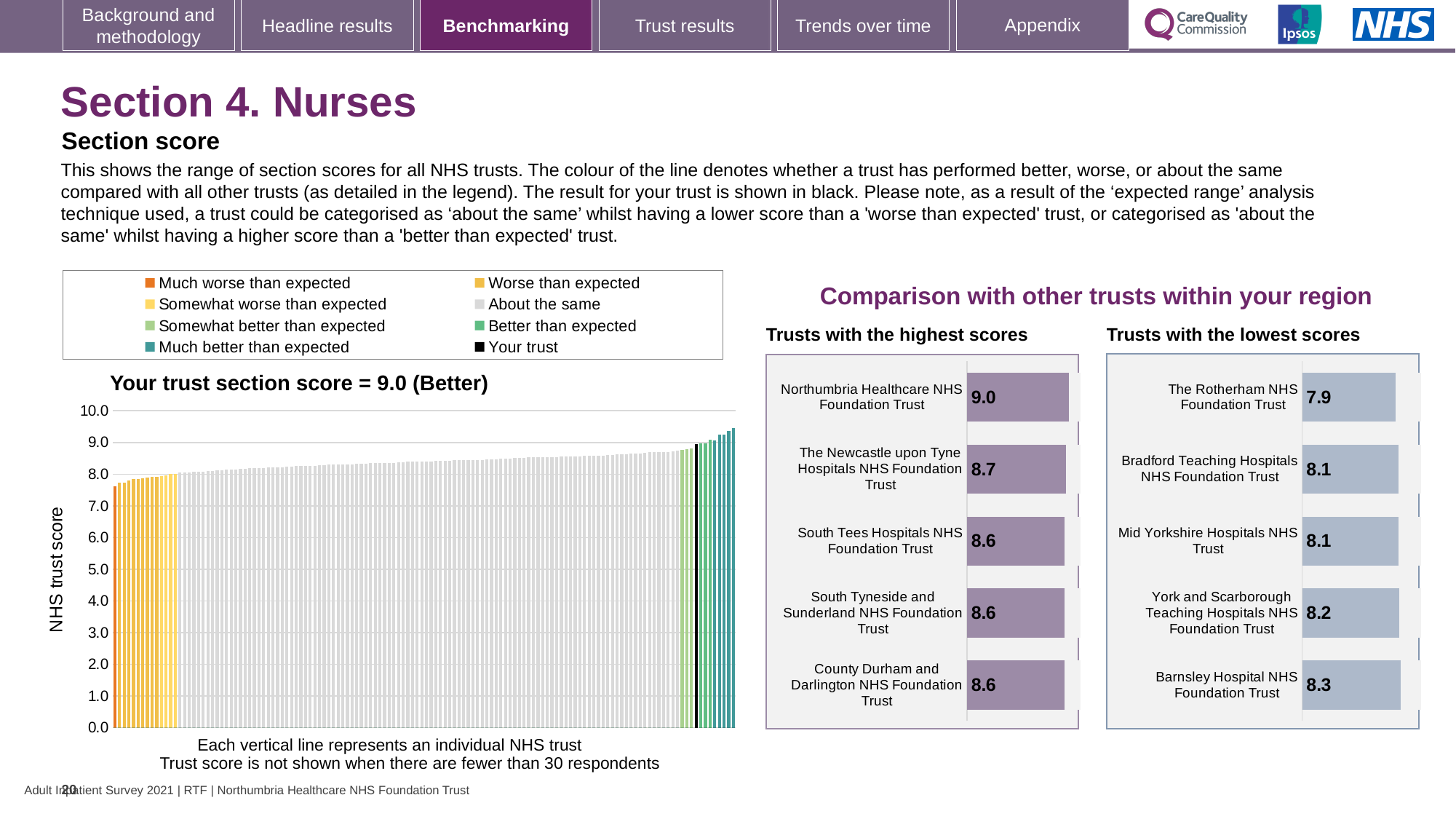
In the chart titled 'Trusts with the highest scores', which trust has the highest score? Northumbria Healthcare NHS Foundation Trust In the chart titled 'Trusts with the highest scores', what is the difference between the scores of Northumbria Healthcare NHS Foundation Trust and The Newcastle upon Tyne Hospitals NHS Foundation Trust? 0.3 In the chart titled 'Trusts with the lowest scores', which trust has the lowest score? The Rotherham NHS Foundation Trust In the chart titled 'Trusts with the highest scores', what is the score for The Newcastle upon Tyne Hospitals NHS Foundation Trust? 8.7 In the chart titled 'Your trust section score = 9.0 (Better)', what is the section score for your trust? 9.0 In the chart titled 'Your trust section score = 9.0 (Better)', is the value of the leftmost (lowest) bar greater or less than 8.0? less How many entries does the legend above the chart titled 'Your trust section score = 9.0 (Better)' list? 8 What kind of chart is the chart titled 'Your trust section score = 9.0 (Better)'? bar chart How many trusts are shown in the chart titled 'Trusts with the lowest scores'? 5 What is the y-axis label of the chart titled 'Your trust section score = 9.0 (Better)'? NHS trust score In the chart titled 'Your trust section score = 9.0 (Better)', do the bar values rise or fall from left to right? rise In the chart titled 'Trusts with the lowest scores', which has the larger score: Barnsley Hospital NHS Foundation Trust or The Rotherham NHS Foundation Trust? Barnsley Hospital NHS Foundation Trust